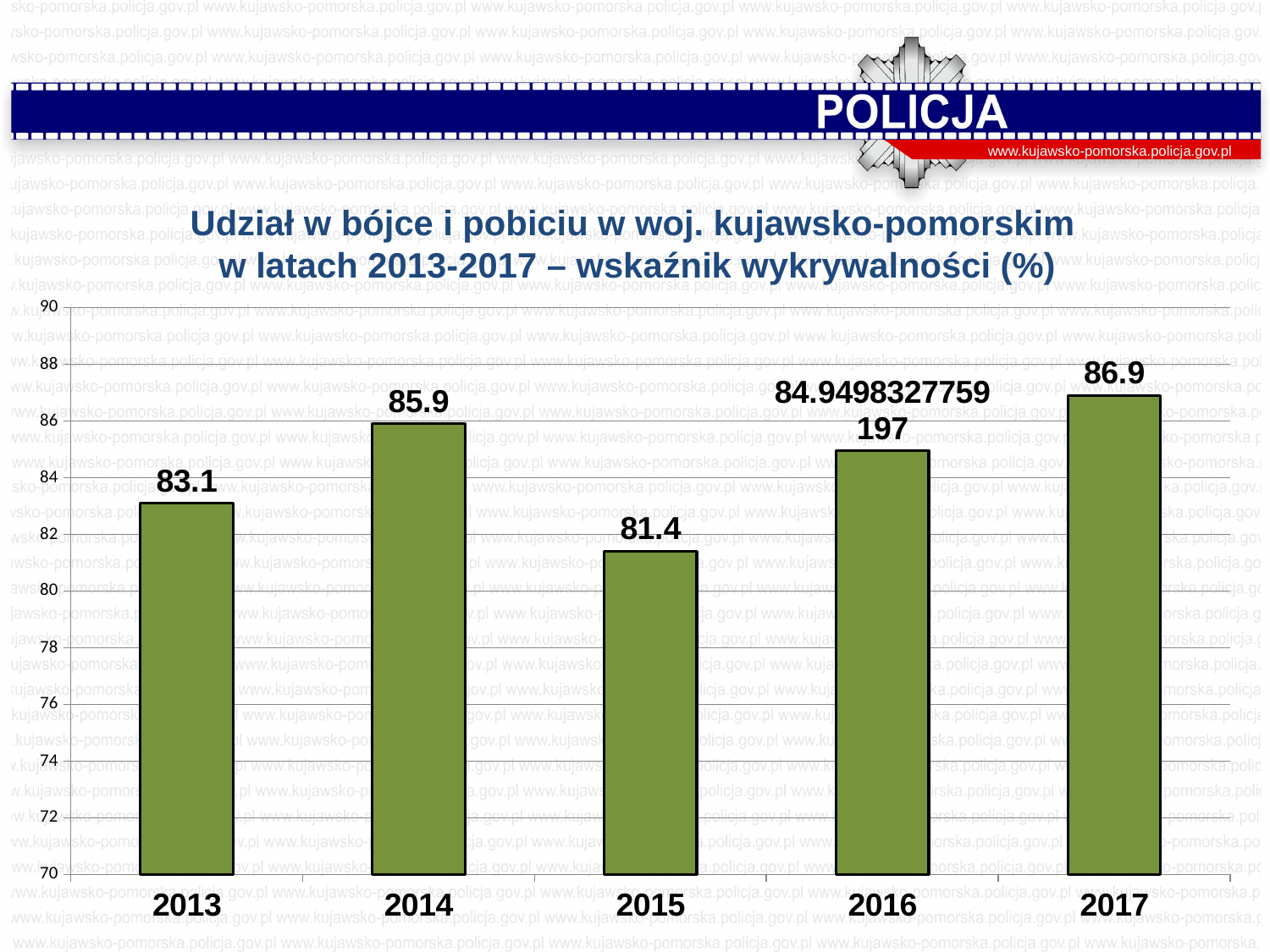
How many years are shown on the x axis? 5 What is the value for 2015? 81.4 What is the value for 2013? 83.1 What is the data label shown for 2016? 84.9498327759197 What is the value for 2017? 86.9 Which year has the lowest value? 2015 Which year has the highest value? 2017 Is the value for 2015 greater or less than 82? less What is the difference between the values for 2017 and 2014? 1.0 What kind of chart is shown on the slide? bar chart Which is larger, the value for 2013 or the value for 2015? 2013 What is the difference between the values for 2014 and 2013? 2.8